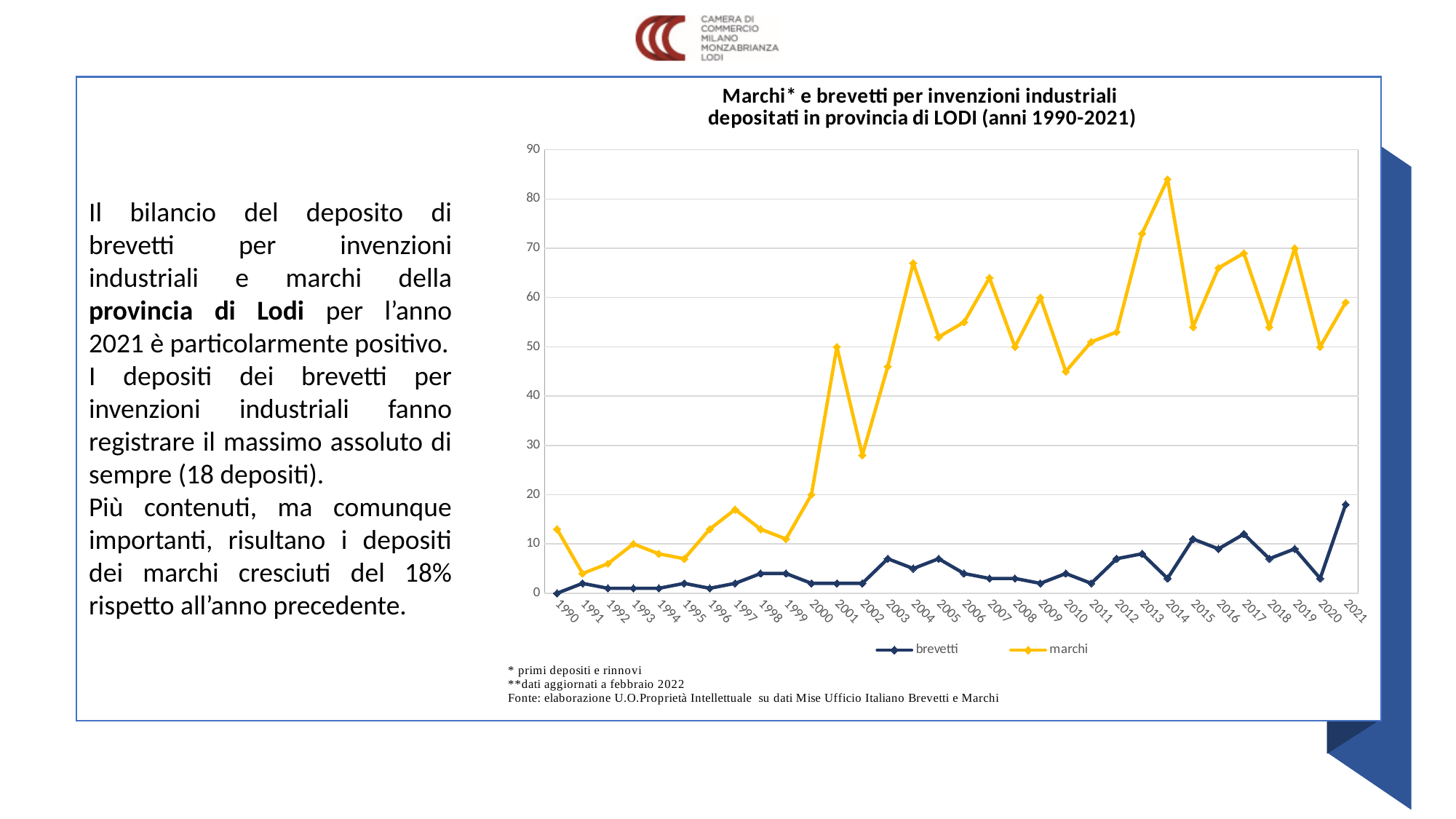
Which colour is used for the marchi series in the chart? yellow How many brevetti depositi were registered in 2021, according to the slide? 18 Is the value for marchi in 2002 greater or less than 30? less In which year does the marchi series reach its lowest value? 1991 Is the value for marchi in 2010 greater or less than 50? less In 2021, which series has the larger value, brevetti or marchi? marchi What kind of chart is shown on the slide? line chart How many years are plotted along the x axis of the chart? 32 In which year does the brevetti series reach its highest value? 2021 In which year does the marchi series reach its highest value? 2014 Is the value for marchi in 2014 greater or less than 80? greater How many series does the chart legend list? 2